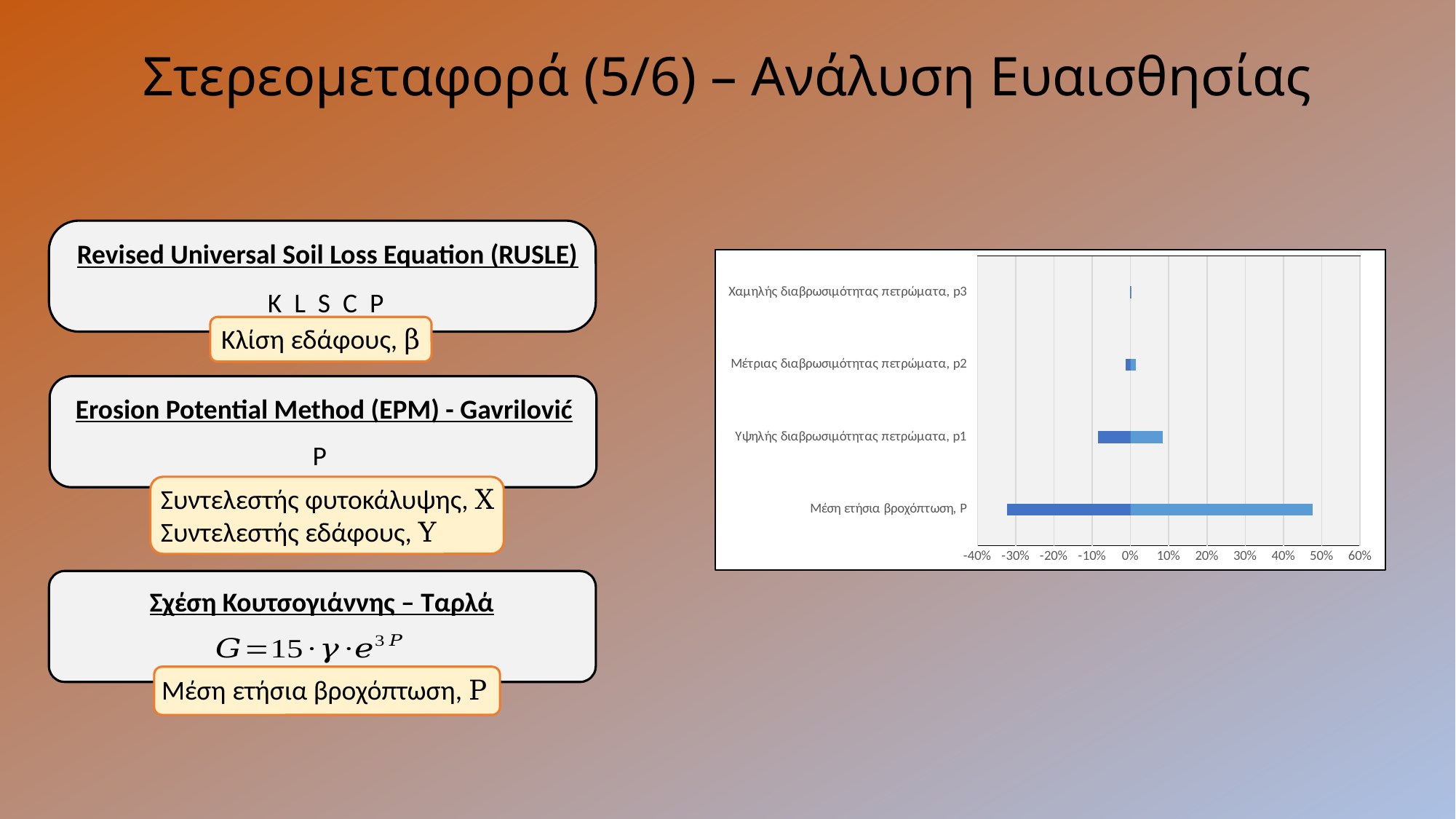
Is the positive (light blue) value for Μέση ετήσια βροχόπτωση, P greater or less than 50%? less Which has a larger positive value: Υψηλής διαβρωσιμότητας πετρώματα, p1 or Μέτριας διαβρωσιμότητας πετρώματα, p2? Υψηλής διαβρωσιμότητας πετρώματα, p1 Which has a larger positive value: Μέση ετήσια βροχόπτωση, P or Υψηλής διαβρωσιμότητας πετρώματα, p1? Μέση ετήσια βροχόπτωση, P How many categories are plotted on the chart? 4 What kind of chart is shown on the right side of the slide? bar chart Is the positive (light blue) value for Υψηλής διαβρωσιμότητας πετρώματα, p1 greater or less than 10%? less What are the minimum and maximum tick values shown on the horizontal axis of the chart? -40% and 60% Which category has the shortest bars on the chart? Χαμηλής διαβρωσιμότητας πετρώματα, p3 Which category has the longest bars on the chart? Μέση ετήσια βροχόπτωση, P Is the negative (dark blue) value for Μέση ετήσια βροχόπτωση, P greater or less than -20%? less